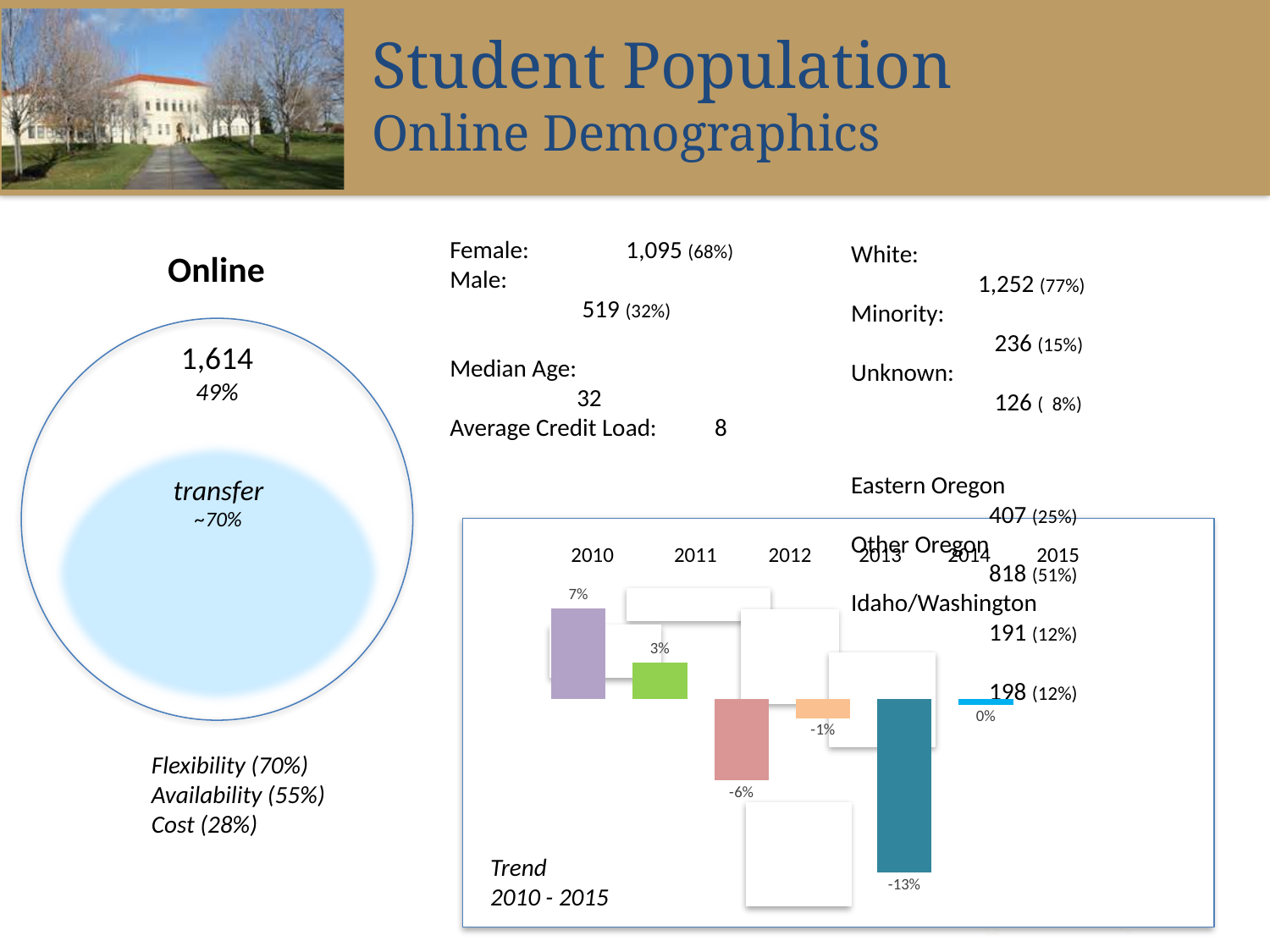
In the Trend 2010 - 2015 chart, what is the value for 2011? 3% In the Trend 2010 - 2015 chart, which year has the highest value? 2010 In the Trend 2010 - 2015 chart, do the values rise or fall from 2010 to 2012? fall In the Trend 2010 - 2015 chart, which year has the larger value, 2012 or 2013? 2013 What kind of chart is shown in the Trend 2010 - 2015 box? bar chart In the Trend 2010 - 2015 chart, what is the value for 2015? 0% In the Trend 2010 - 2015 chart, what is the value for 2010? 7% In the Trend 2010 - 2015 chart, which year has the lowest value? 2014 In the Trend 2010 - 2015 chart, what is the value for 2014? -13% In the Trend 2010 - 2015 chart, what is the difference between the values for 2010 and 2011? 4 percentage points In the Trend 2010 - 2015 chart, what is the value for 2012? -6% How many years are shown in the Trend 2010 - 2015 chart? 6